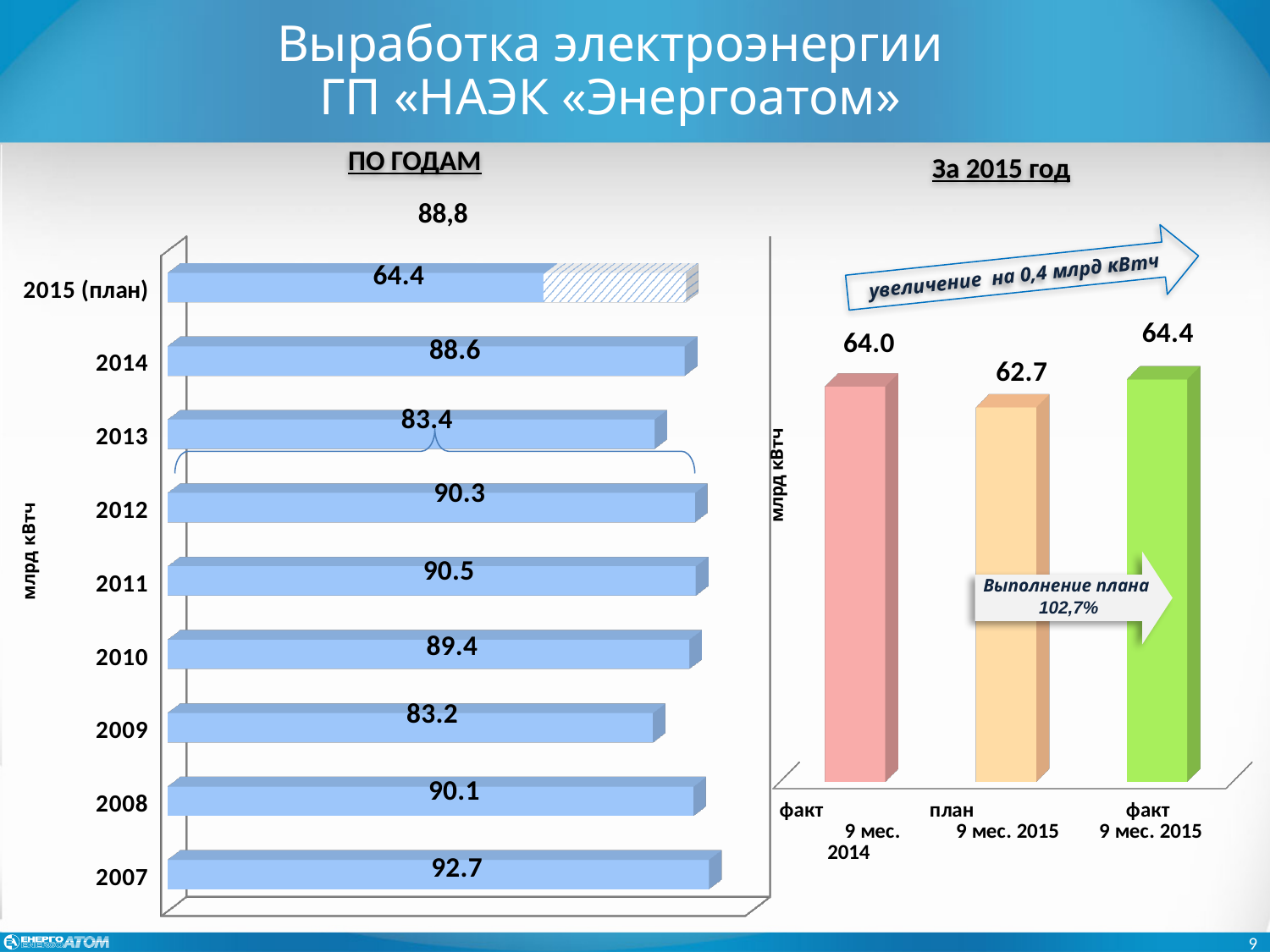
In the left chart 'ПО ГОДАМ', what is the difference between the values for 2014 and 2013? 5.2 In the left chart 'ПО ГОДАМ', which year from 2007 to 2014 has the lowest value? 2009 In the right chart 'За 2015 год', which category has the lowest value? план 9 мес. 2015 What kind of chart is the right chart 'За 2015 год'? bar chart How many bars (years) are shown in the left chart 'ПО ГОДАМ'? 9 In the left chart 'ПО ГОДАМ', what is the value shown on the solid bar for 2015 (план)? 64.4 In the left chart 'ПО ГОДАМ', what is the value for 2014? 88.6 In the left chart 'ПО ГОДАМ', which year has the highest value? 2007 In the right chart 'За 2015 год', what is the value for план 9 мес. 2015? 62.7 In the right chart 'За 2015 год', what is the difference between факт 9 мес. 2015 and план 9 мес. 2015? 1.7 In the left chart 'ПО ГОДАМ', which is larger: the value for 2010 or the value for 2009? 2010 In the left chart 'ПО ГОДАМ', what is the value for 2007? 92.7